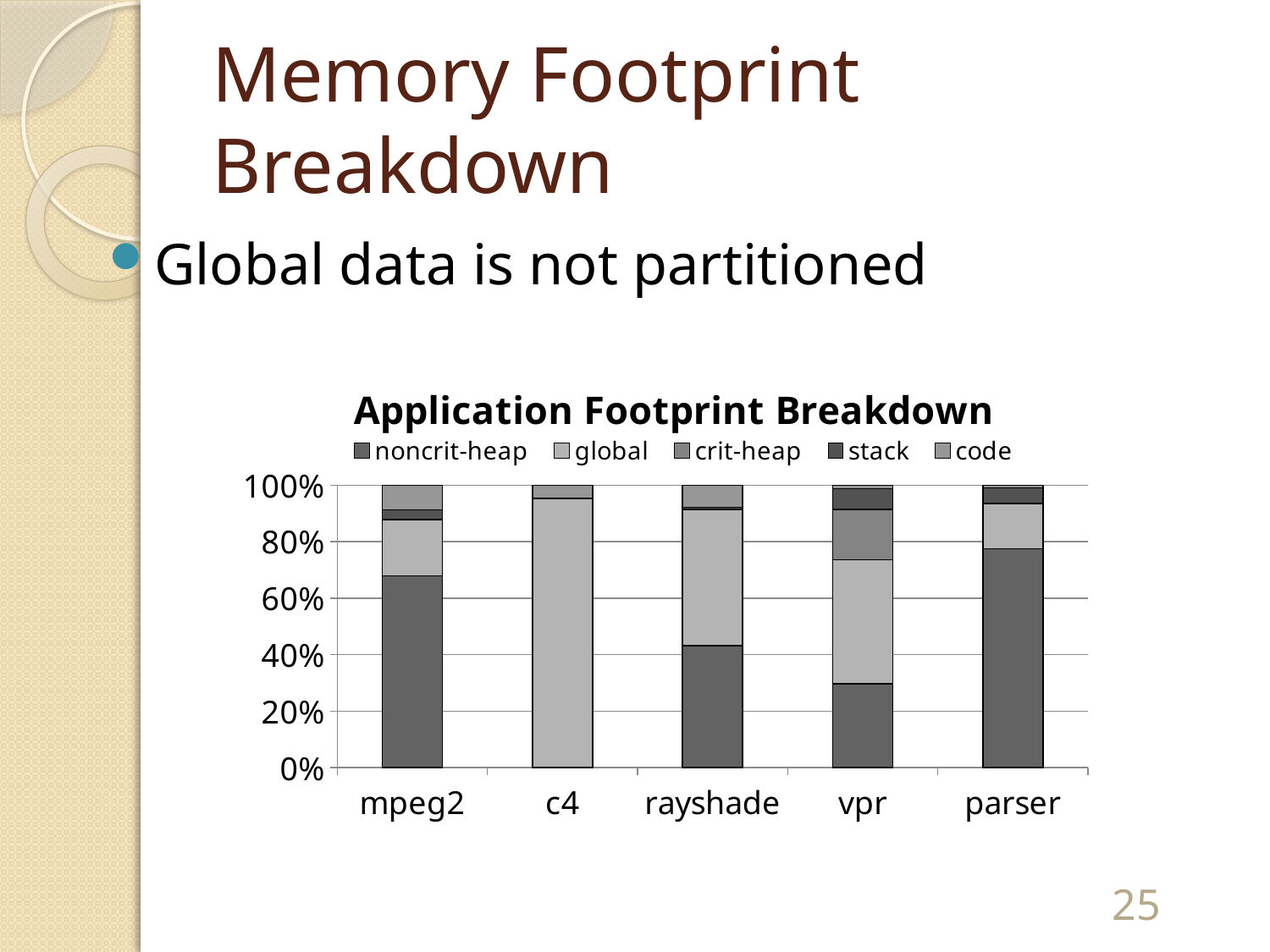
What is the title of the chart? Application Footprint Breakdown Which application has the largest noncrit-heap share? parser Is the noncrit-heap share for mpeg2 greater or less than 60%? greater Is the noncrit-heap share for vpr greater or less than 40%? less Which has the larger noncrit-heap share, mpeg2 or vpr? mpeg2 How many applications (categories) are shown on the x axis? 5 Is the noncrit-heap share for rayshade greater or less than 60%? less What is the total height of each stacked bar in the chart? 100% How many series does the chart legend list? 5 Which application has the largest global share? c4 What type of chart is shown on the slide? stacked bar chart Which application has the smallest noncrit-heap share? c4